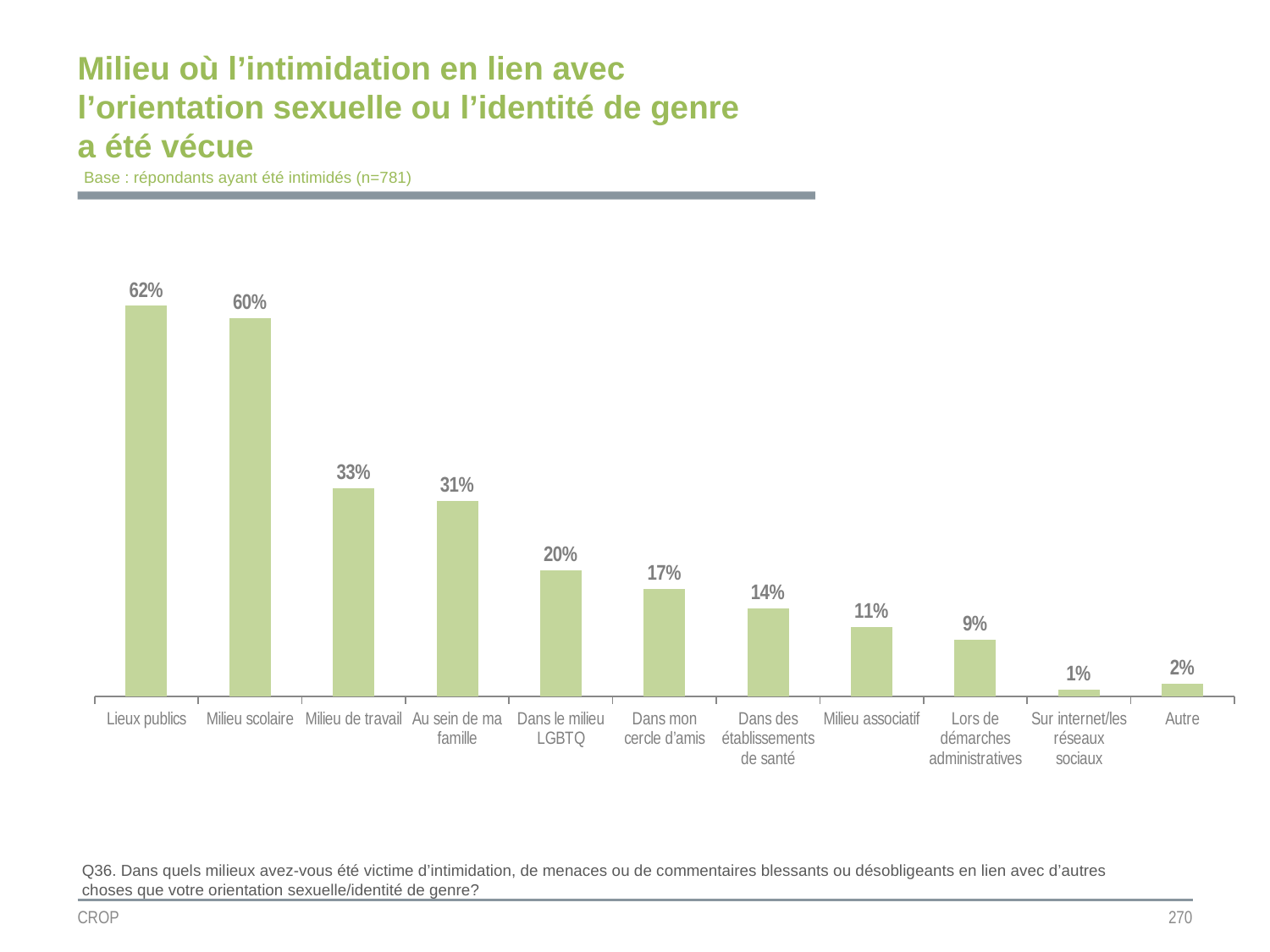
What is the value for Dans le milieu LGBTQ? 20% Which category has the highest value? Lieux publics Which is larger, the value for Dans mon cercle d'amis or the value for Dans des établissements de santé? Dans mon cercle d'amis Which category has the lowest value? Sur internet/les réseaux sociaux How many categories are shown on the x axis? 11 What is the difference between the values for Milieu de travail and Au sein de ma famille? 2% What is the value for Milieu de travail? 33% What is the difference between the values for Lieux publics and Milieu scolaire? 2% What is the base (n) stated under the chart title? n=781 What is the value for Sur internet/les réseaux sociaux? 1% What kind of chart is shown on the slide? Bar chart What is the value for Lieux publics? 62%